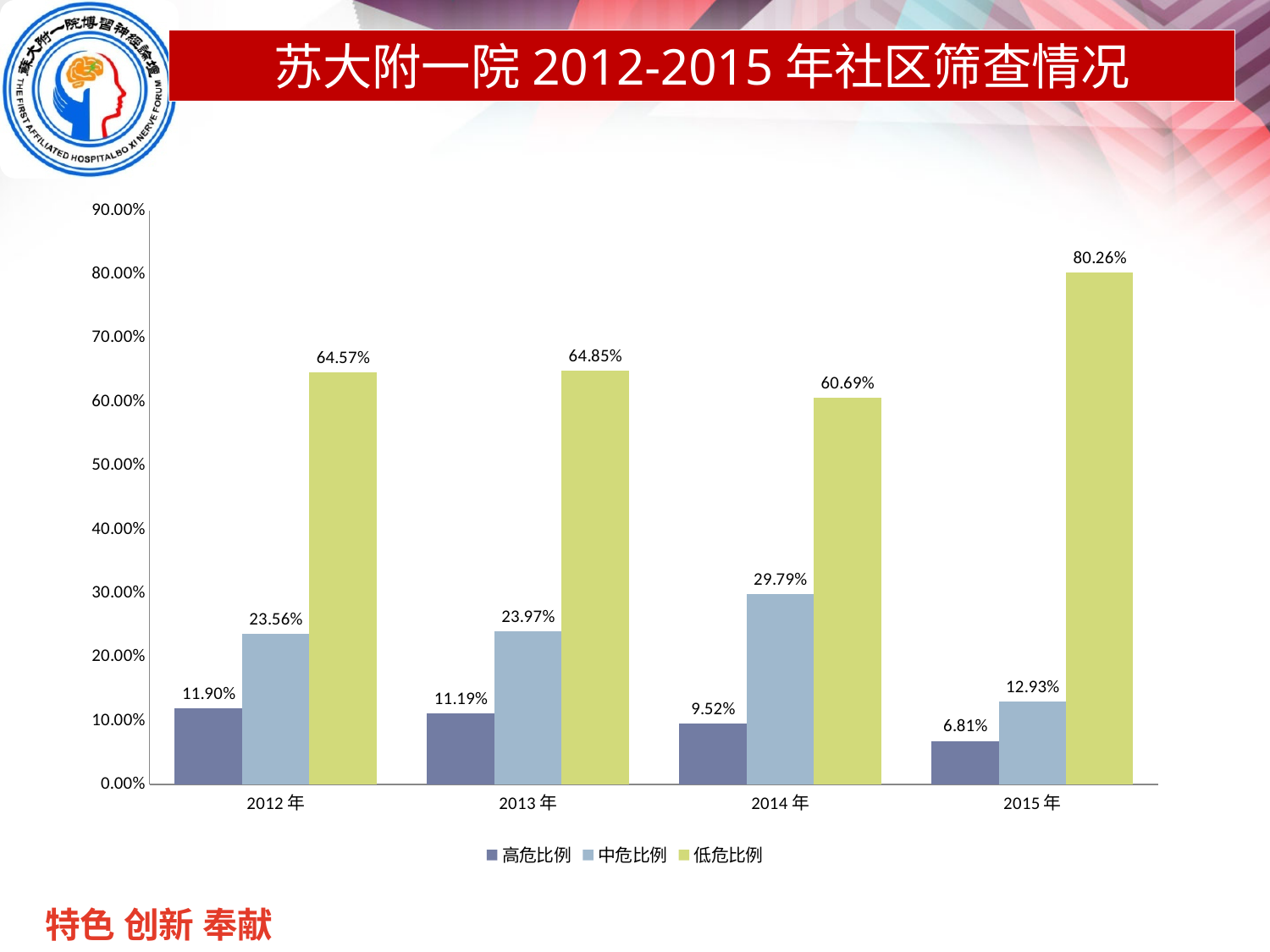
Is the 低危比例 value for 2014年 greater or less than 70.00%? less What is the 高危比例 value for 2012年? 11.90% What is the difference between the 中危比例 values for 2014年 and 2013年? 5.82% Does the 高危比例 value rise or fall from 2012年 to 2015年? fall What kind of chart is shown on the slide? bar chart Which year has the lowest 高危比例 value? 2015年 How many series does the legend list? 3 What is the 中危比例 value for 2014年? 29.79% How many years are shown on the x axis? 4 What is the 低危比例 value for 2015年? 80.26% Which year has the highest 低危比例 value? 2015年 Which is larger, the 低危比例 value for 2012年 or for 2013年? 2013年